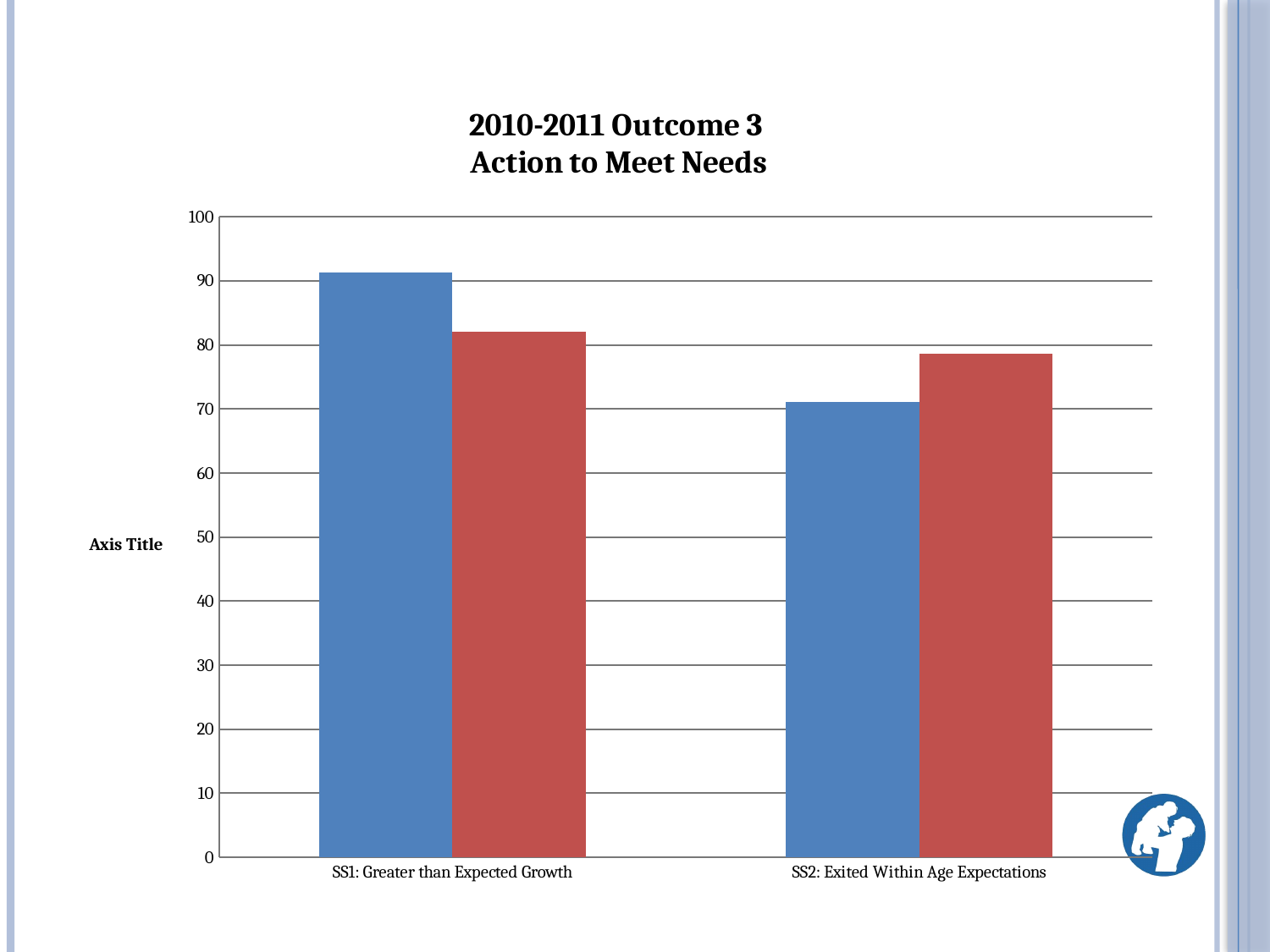
What kind of chart is shown on the slide? bar chart What is the highest value shown on the vertical axis? 100 For SS1: Greater than Expected Growth, which bar is taller, the blue one or the red one? the blue one What is the title of the chart? 2010-2011 Outcome 3 Action to Meet Needs Is the red bar for SS2: Exited Within Age Expectations greater or less than 70? greater How many categories are shown on the x axis? 2 Which category has the taller blue bar, SS1: Greater than Expected Growth or SS2: Exited Within Age Expectations? SS1: Greater than Expected Growth Is the red bar for SS1: Greater than Expected Growth greater or less than 90? less Which category contains the tallest bar in the chart? SS1: Greater than Expected Growth Is the blue bar for SS1: Greater than Expected Growth greater or less than 80? greater For SS2: Exited Within Age Expectations, which bar is taller, the blue one or the red one? the red one